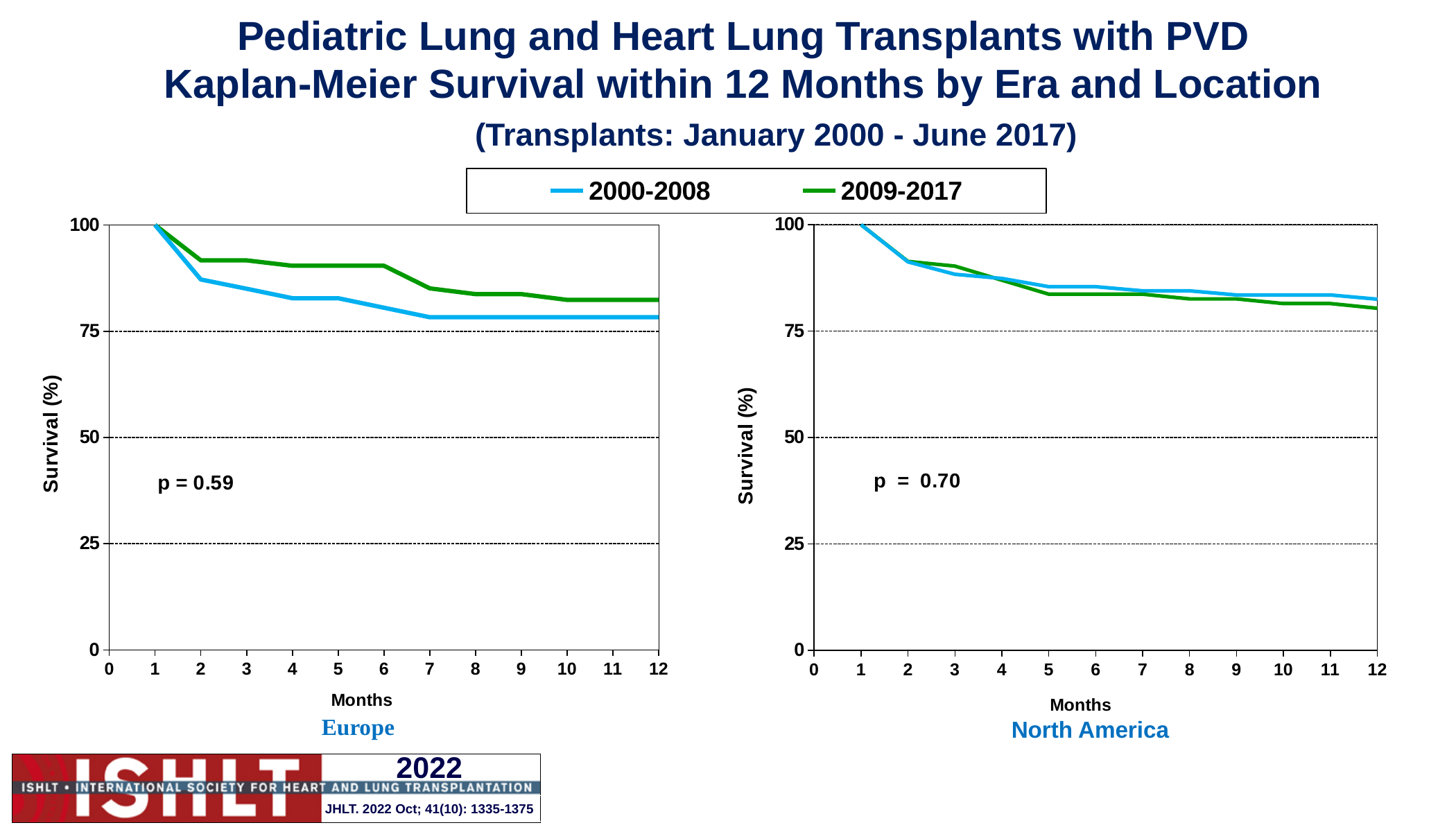
In the Europe chart, which era has the lower survival at 4 months, 2000-2008 or 2009-2017? 2000-2008 In the North America chart, is the survival value for 2009-2017 at 12 months greater or less than 75? greater In the Europe chart, is the survival value for 2000-2008 at 12 months greater or less than 75? greater In the North America chart, does survival rise or fall as months increase? fall In the Europe chart, is the survival value for 2009-2017 at 6 months greater or less than 75? greater What kind of chart is the Europe chart? line chart In the Europe chart, does survival rise or fall as months increase? fall How many series does the legend list? 2 What p-value is shown on the North America chart? p = 0.70 In the Europe chart, which era has the higher survival at 12 months, 2000-2008 or 2009-2017? 2009-2017 What is the highest month shown on the x axis of the North America chart? 12 What p-value is shown on the Europe chart? p = 0.59